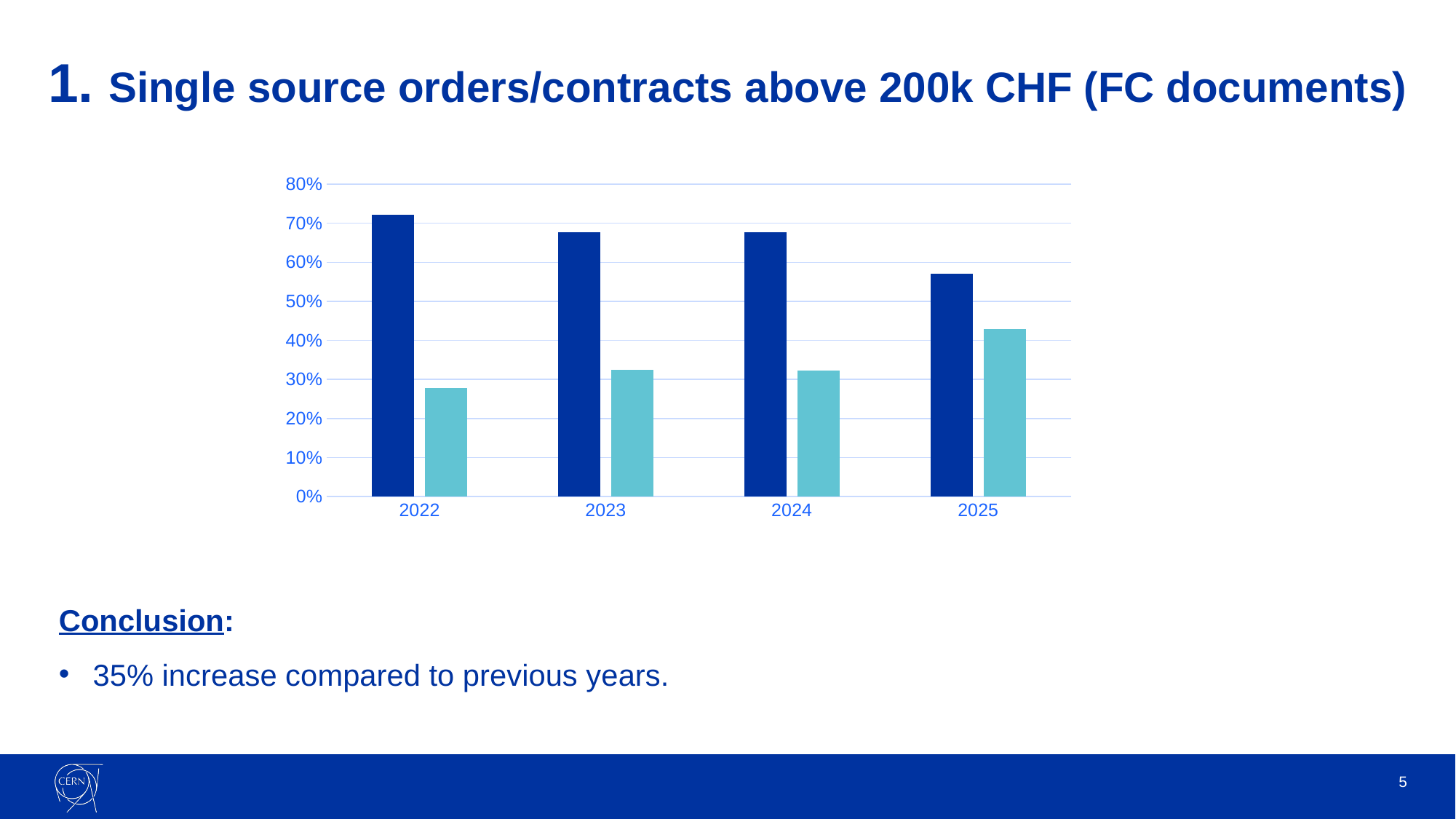
How many years are shown on the x axis of the chart? 4 In which year is the light blue bar the tallest? 2025 In which year is the dark blue bar the tallest? 2022 Does the dark blue series rise or fall from 2022 to 2025? fall Is the dark blue bar for 2025 greater or less than 60%? less In which year is the light blue bar the shortest? 2022 In 2025, which bar is taller, the dark blue one or the light blue one? dark blue Is the light blue bar for 2025 greater or less than 40%? greater Is the dark blue bar for 2022 greater or less than 70%? greater How many bars are plotted for each year in the chart? 2 What kind of chart is shown on the slide? bar chart In which year is the dark blue bar the shortest? 2025